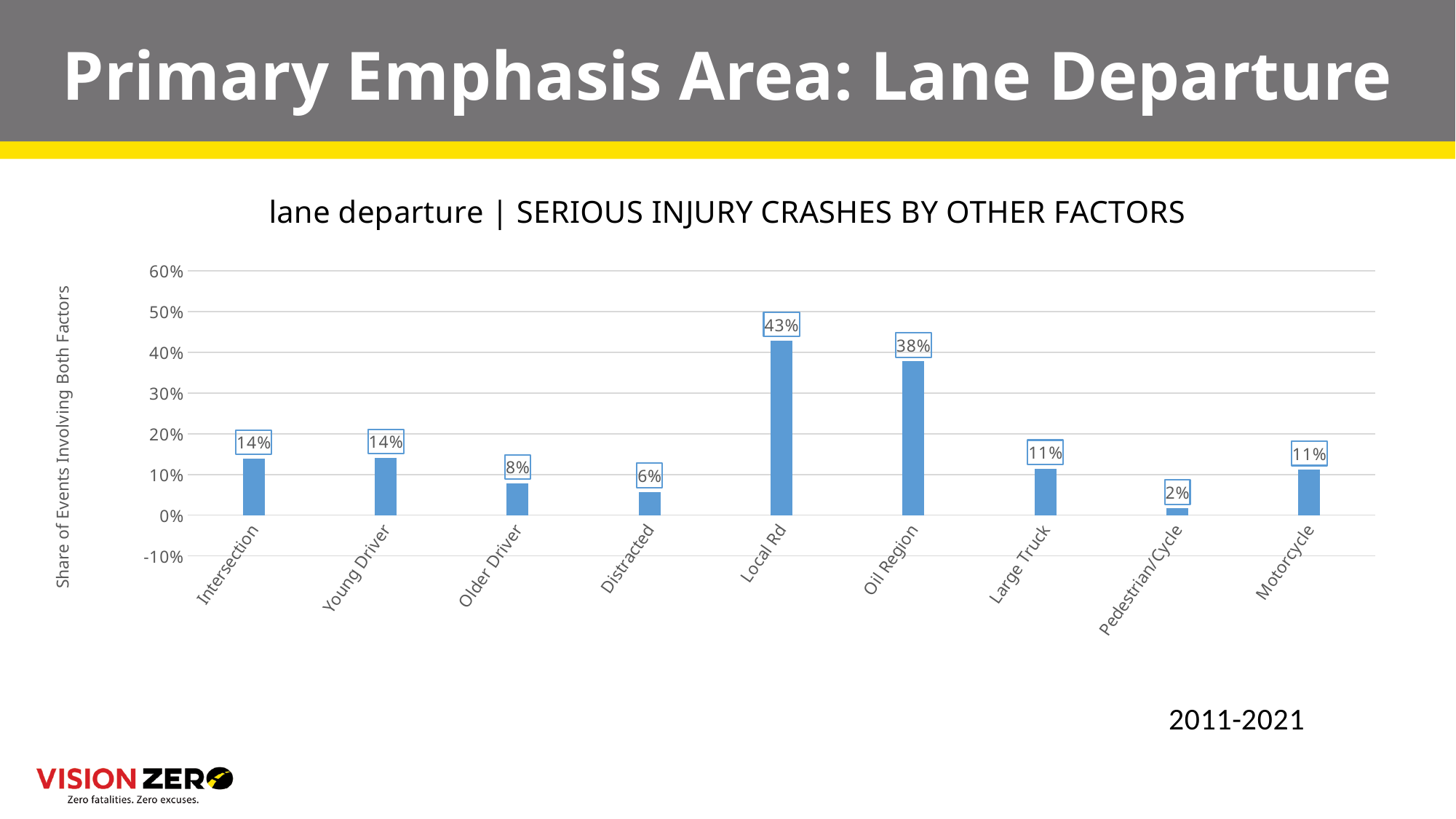
Which category has the lowest value? Pedestrian/Cycle What is the value for Oil Region? 38% What is the value for Distracted? 6% What is the value for Pedestrian/Cycle? 2% How many categories are shown on the x axis? 9 Is the value for Oil Region greater or less than 30%? greater Which is larger, the value for Older Driver or the value for Large Truck? Large Truck Which category has the highest value? Local Rd What is the difference between the values for Local Rd and Oil Region? 5% What is the title of the chart? lane departure | SERIOUS INJURY CRASHES BY OTHER FACTORS What kind of chart is shown on the slide? bar chart What is the value for Local Rd? 43%